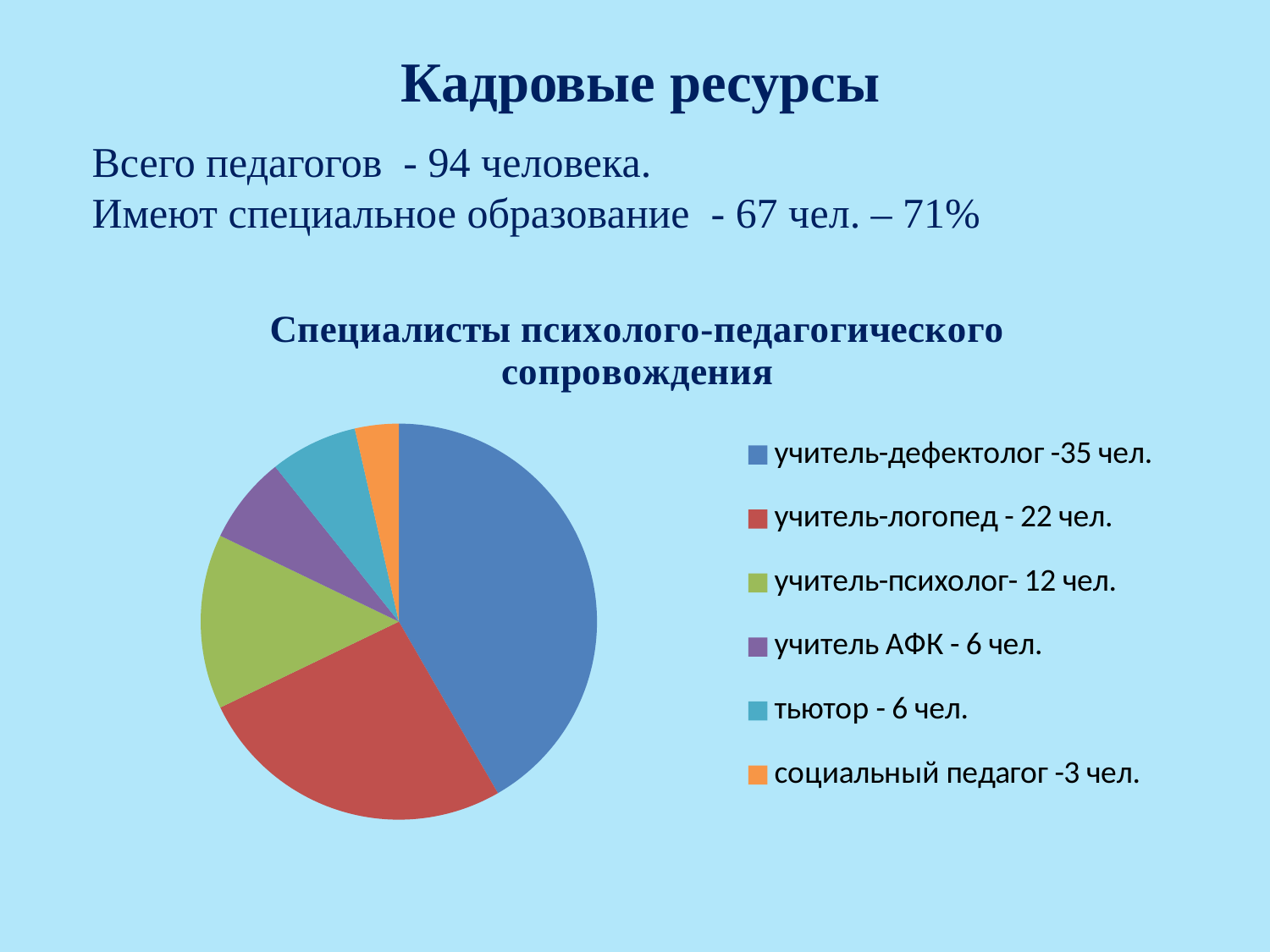
Which category has the largest slice of the pie? учитель-дефектолог How many categories does the pie chart have? 6 What is the title of the pie chart? Специалисты психолого-педагогического сопровождения What kind of chart is shown on the slide? pie chart What is the difference between the number of учитель-дефектолог and учитель-логопед? 13 How many учитель-психолог are there according to the legend? 12 чел. Which category has the smallest slice of the pie? социальный педагог What colour is the slice for учитель-логопед? red How many учитель-дефектолог are there according to the legend? 35 чел. How many социальный педагог are there according to the legend? 3 чел. Which is larger: the number of учитель-психолог or the number of тьютор? учитель-психолог How many учитель-логопед are there according to the legend? 22 чел.